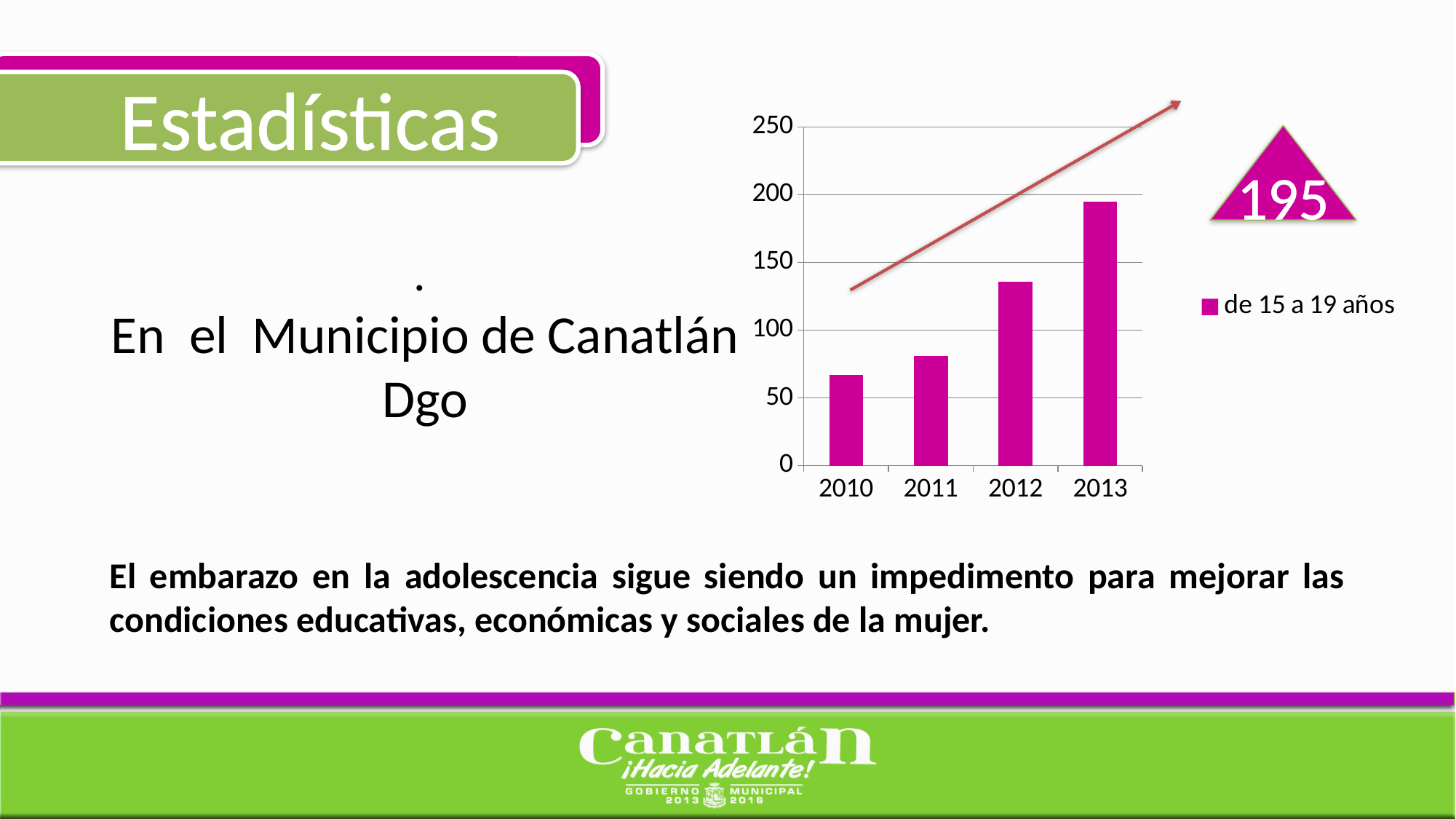
How many years are shown on the x axis of the chart? 4 Is the value for 2012 greater or less than 100? greater Which year has the lowest bar in the chart? 2010 Is the value for 2013 greater or less than 150? greater What is the series name shown in the chart legend? de 15 a 19 años How many series does the chart legend list? 1 Which year has the larger value, 2011 or 2012? 2012 What kind of chart is shown on the slide? bar chart Do the values rise or fall from 2010 to 2013? rise Is the value for 2011 greater or less than 50? greater Which year has the highest bar in the chart? 2013